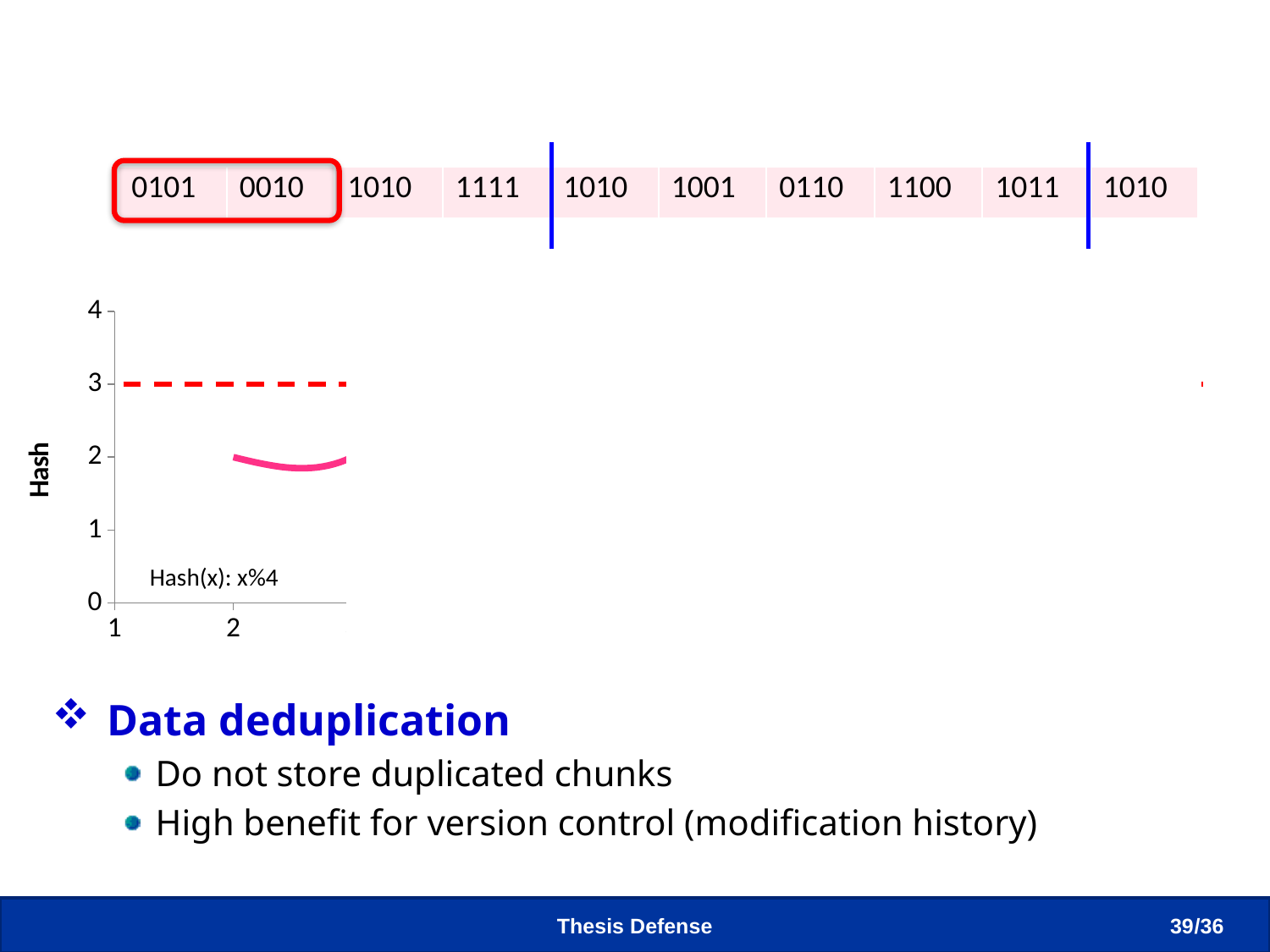
Is the value of the pink curve at x = 2 greater or less than 1? greater What is the title of the y axis of the chart? Hash What formula is written inside the chart's plot area? Hash(x): x%4 What kind of chart is shown on the slide? line chart Is the value of the pink curve at x = 2 greater or less than 3? less Is the red dashed line in the chart above or below the pink curve? above